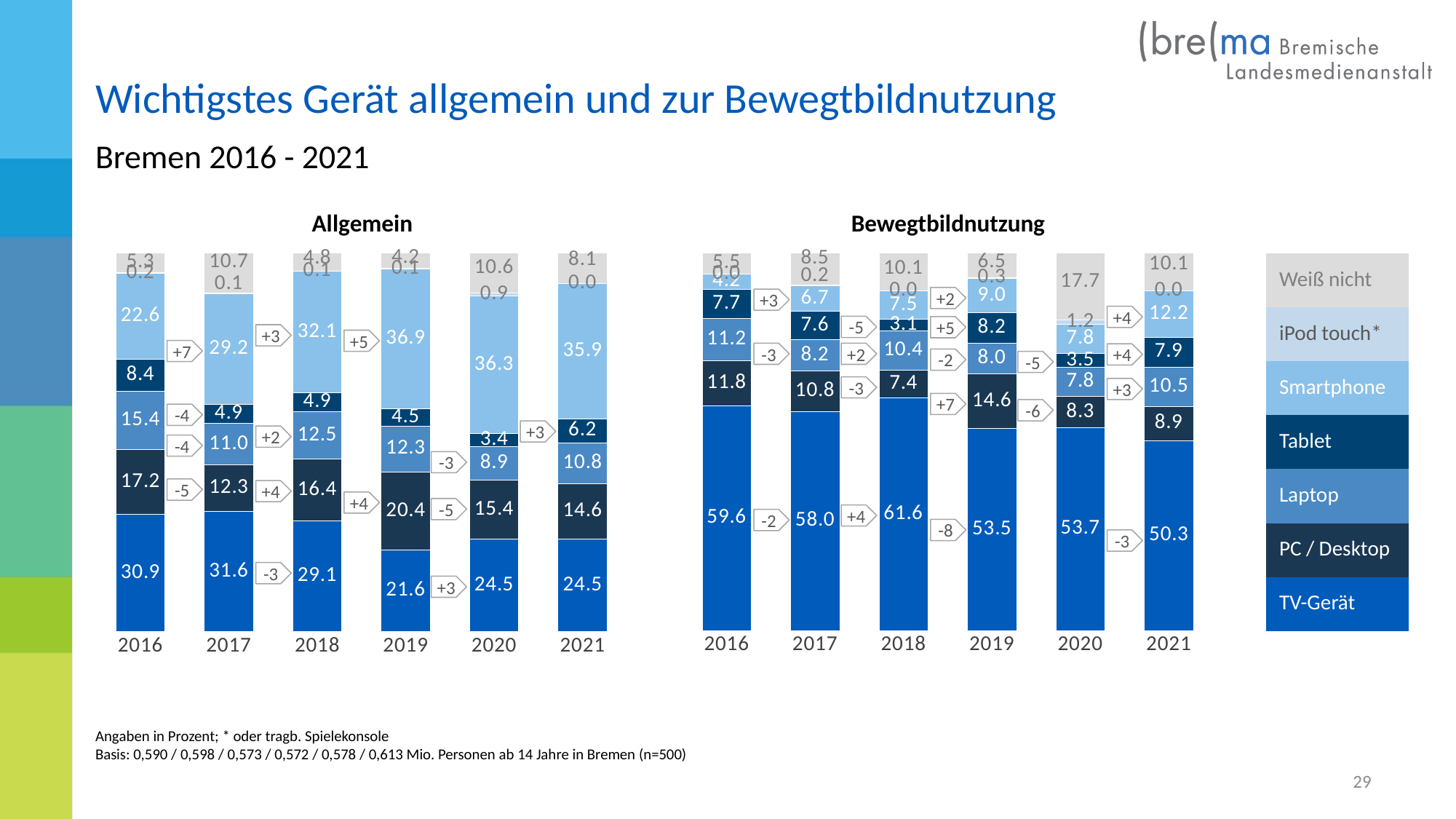
What kind of chart is the Bewegtbildnutzung chart? Stacked bar chart How many years are shown on the x axis of the Allgemein chart? 6 In the Allgemein chart, what is the value for TV-Gerät in 2016? 30.9 How many series does the legend list? 7 In the Bewegtbildnutzung chart, what is the Weiß nicht value for 2020? 17.7 In the Bewegtbildnutzung chart, what is the value for TV-Gerät in 2018? 61.6 In the Bewegtbildnutzung chart, in which year is the TV-Gerät value lowest? 2021 In the Bewegtbildnutzung chart, which is larger: the Laptop value in 2016 or the Laptop value in 2017? 2016 In the Allgemein chart, in which year is the Smartphone value highest? 2019 In the Allgemein chart, what is the difference between the TV-Gerät values for 2017 and 2019? 10.0 In the Allgemein chart, what is the Smartphone value for 2021? 35.9 In the Allgemein chart, does the Smartphone value rise or fall from 2016 to 2019? Rise